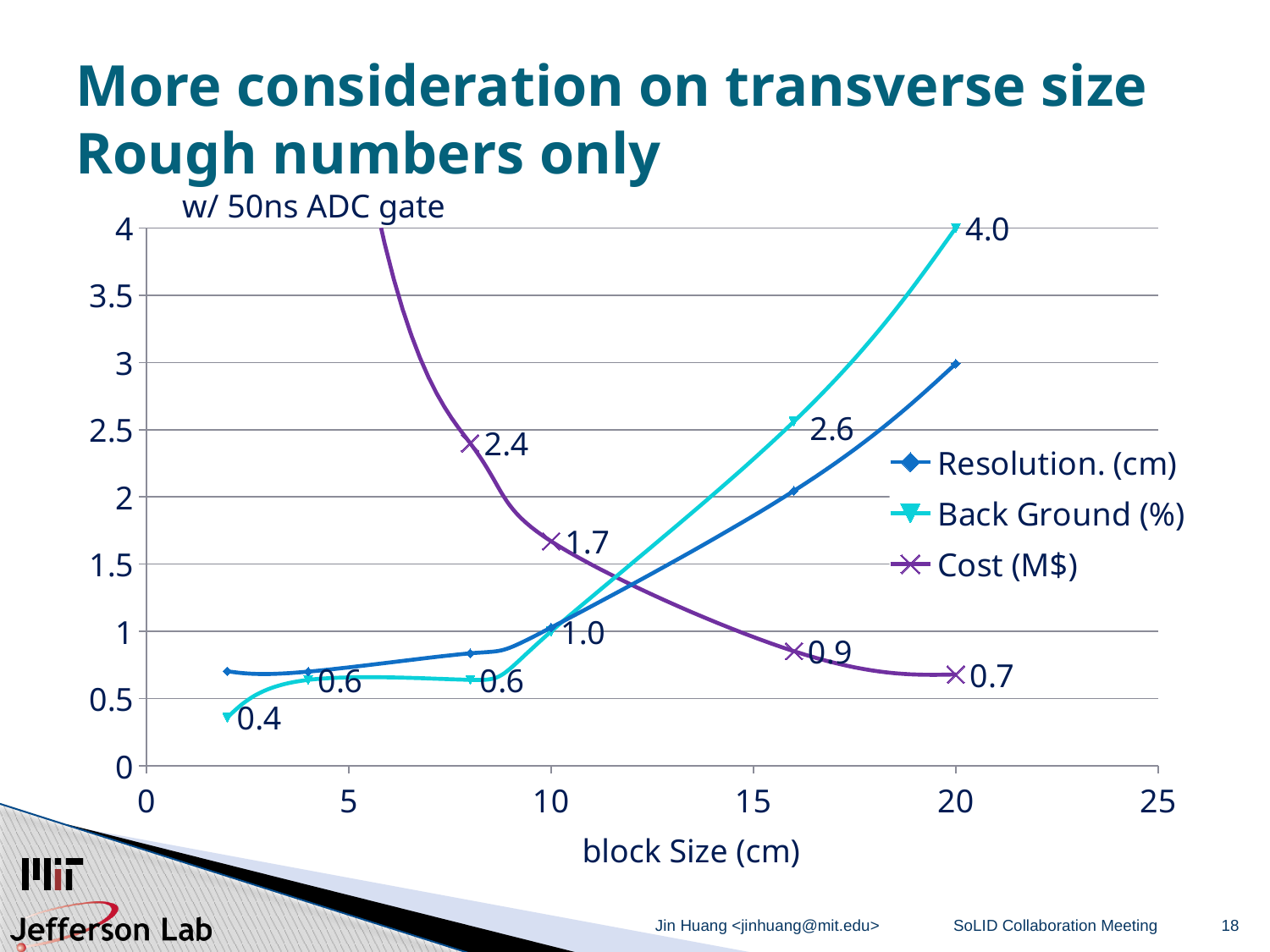
What is the Back Ground (%) value at a block size of 20 cm? 4.0 What is the Back Ground (%) value at a block size of 2 cm? 0.4 What is the title of the x axis? block Size (cm) Does the Cost (M$) series rise or fall as block size increases? falls At a block size of 16 cm, which is larger: Back Ground (%) or Cost (M$)? Back Ground (%) Does the Back Ground (%) series rise or fall as block size increases? rises What is the Cost (M$) value at a block size of 8 cm? 2.4 What kind of chart is shown on the slide? line chart Is the Resolution (cm) value at a block size of 20 cm greater or less than 2.5? greater What is the difference between the Back Ground (%) values at 20 cm and 16 cm block size? 1.4 What is the Cost (M$) value at a block size of 20 cm? 0.7 How many series does the legend list? 3